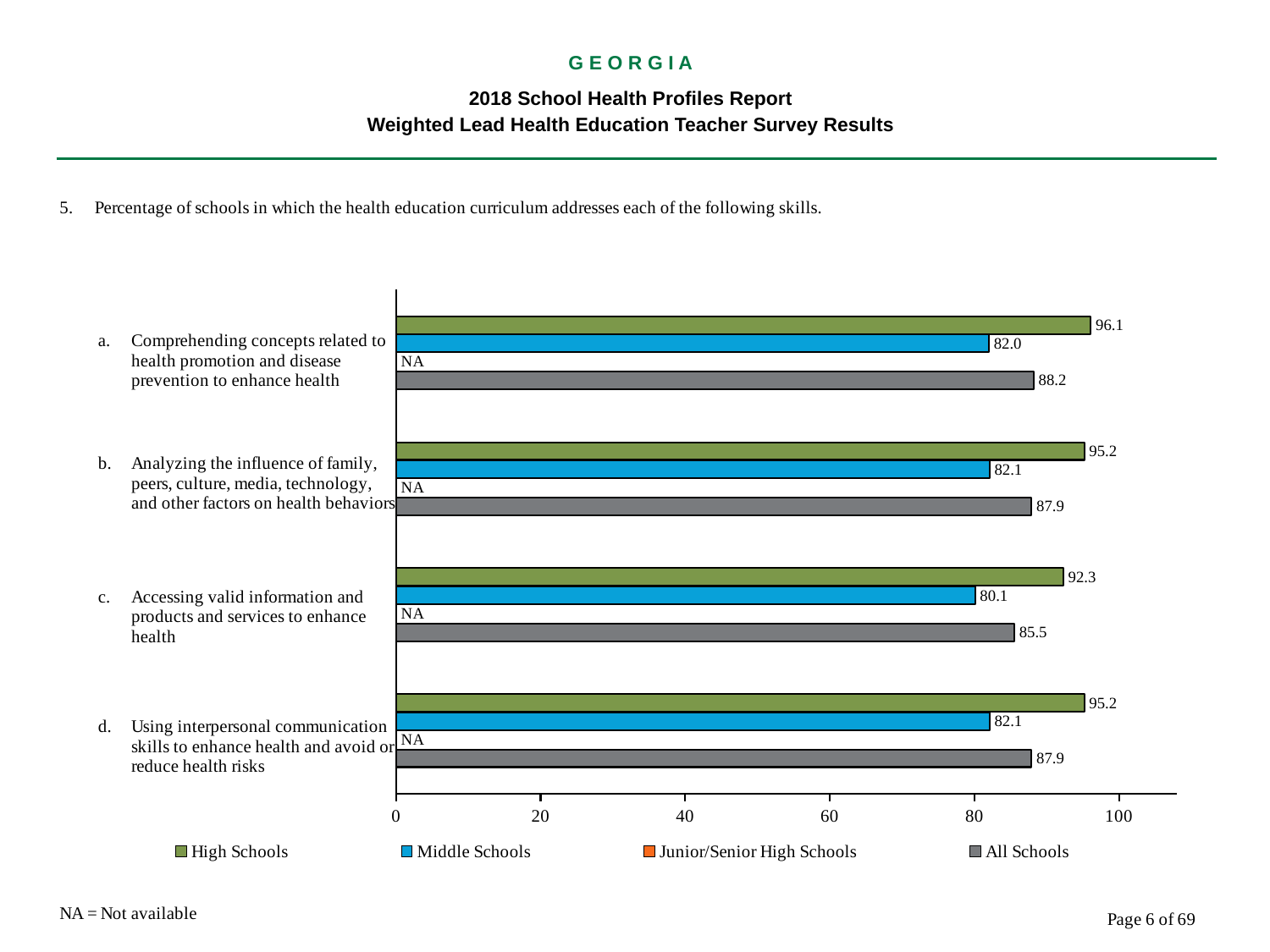
What is the difference between the High Schools and Middle Schools values for skill a? 14.1 What is the Middle Schools value for skill c, accessing valid information and products and services to enhance health? 80.1 How many skills (categories) are shown on the chart? 4 What is the All Schools value for skill b, analyzing the influence of family, peers, culture, media, technology, and other factors on health behaviors? 87.9 How many series does the legend list? 4 What is the High Schools value for skill a, comprehending concepts related to health promotion and disease prevention to enhance health? 96.1 What is the difference between the All Schools values for skill a and skill c? 2.7 Which skill has the highest High Schools value? a. Comprehending concepts related to health promotion and disease prevention to enhance health Which skill has the lowest Middle Schools value? c. Accessing valid information and products and services to enhance health What kind of chart is shown on the slide? Bar chart What value is shown for Junior/Senior High Schools for skill d, using interpersonal communication skills? NA Which is larger for skill c: the High Schools value or the All Schools value? High Schools